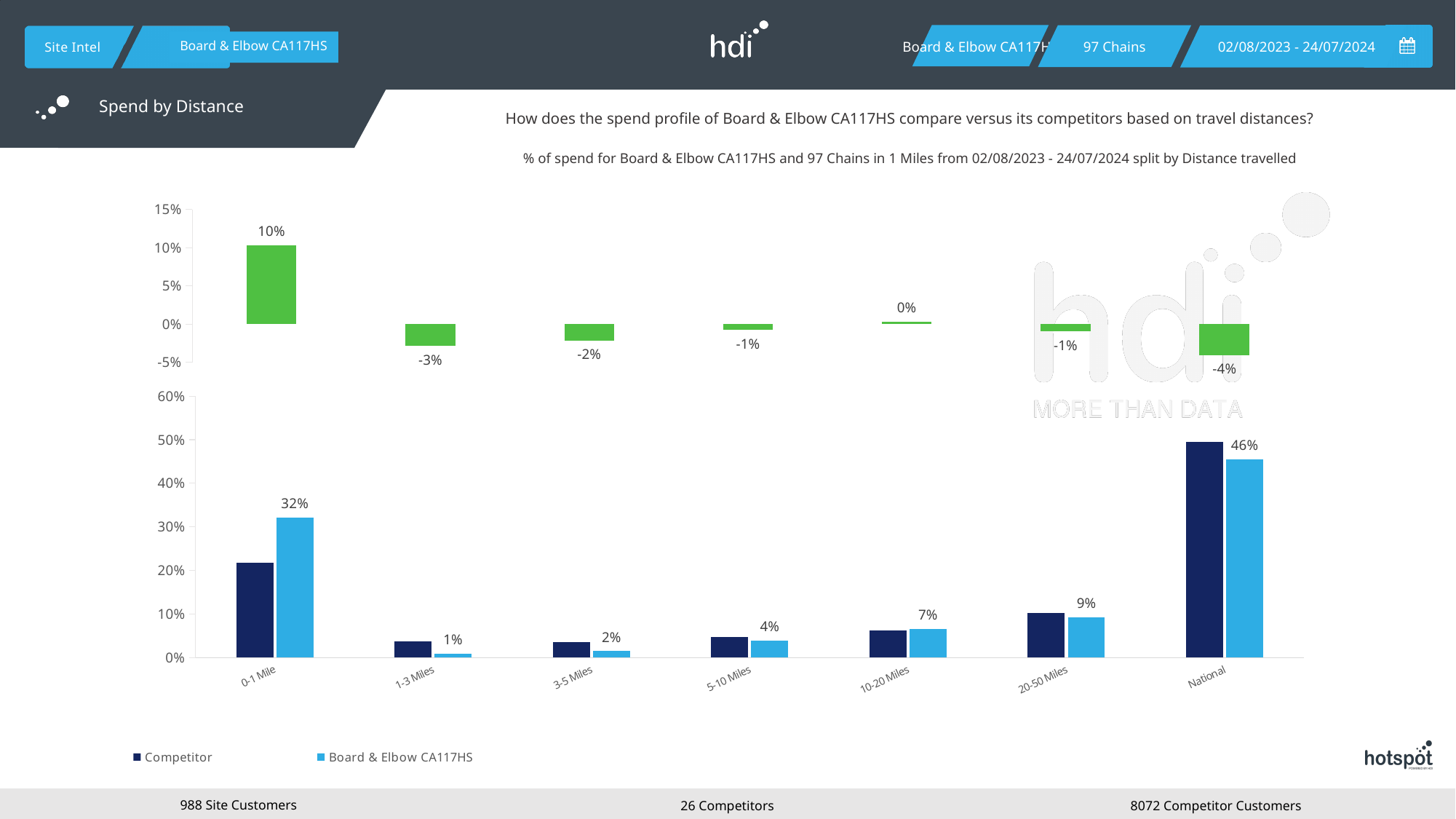
In the bottom chart, which category has the lowest value for Board & Elbow CA117HS? 1-3 Miles In the top green chart, what is the value for the National category? -4% In the bottom chart, which is larger in the 0-1 Mile category: Competitor or Board & Elbow CA117HS? Board & Elbow CA117HS In the bottom chart, is the Competitor value for 0-1 Mile greater or less than 20%? greater In the top green chart, what is the value for the 0-1 Mile category? 10% In the bottom chart, which category has the highest value for Board & Elbow CA117HS? National In the bottom chart, what is the value for Board & Elbow CA117HS in the 0-1 Mile category? 32% In the bottom chart, what is the value for Board & Elbow CA117HS in the National category? 46% In the bottom chart, what is the difference between the Board & Elbow CA117HS values for National and 0-1 Mile? 14% In the bottom chart, what is the value for Board & Elbow CA117HS in the 20-50 Miles category? 9% How many series does the legend of the bottom chart list? 2 How many distance categories are shown on the x axis of the bottom chart? 7